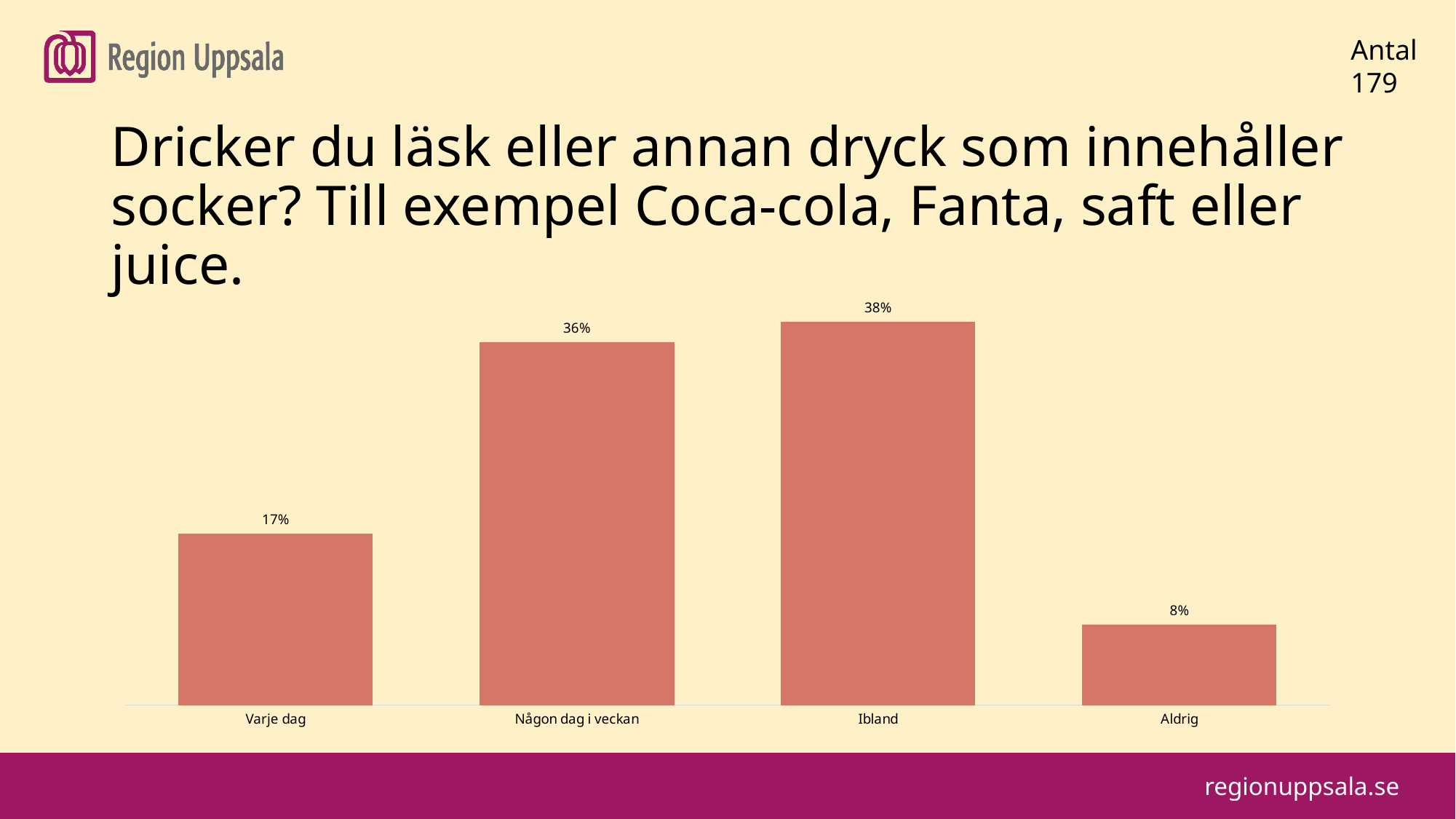
What is the value for Varje dag? 17% What is the value for Ibland? 38% How many categories are shown in the chart? 4 What kind of chart is shown on the slide? Bar chart Which category has the highest value? Ibland What is the value for Aldrig? 8% What is the difference between the values for Någon dag i veckan and Aldrig? 28% Which is larger, the value for Varje dag or the value for Aldrig? Varje dag What is the value for Någon dag i veckan? 36% What is the number of respondents (Antal) shown on the slide? 179 What is the difference between the values for Ibland and Varje dag? 21% Which category has the lowest value? Aldrig